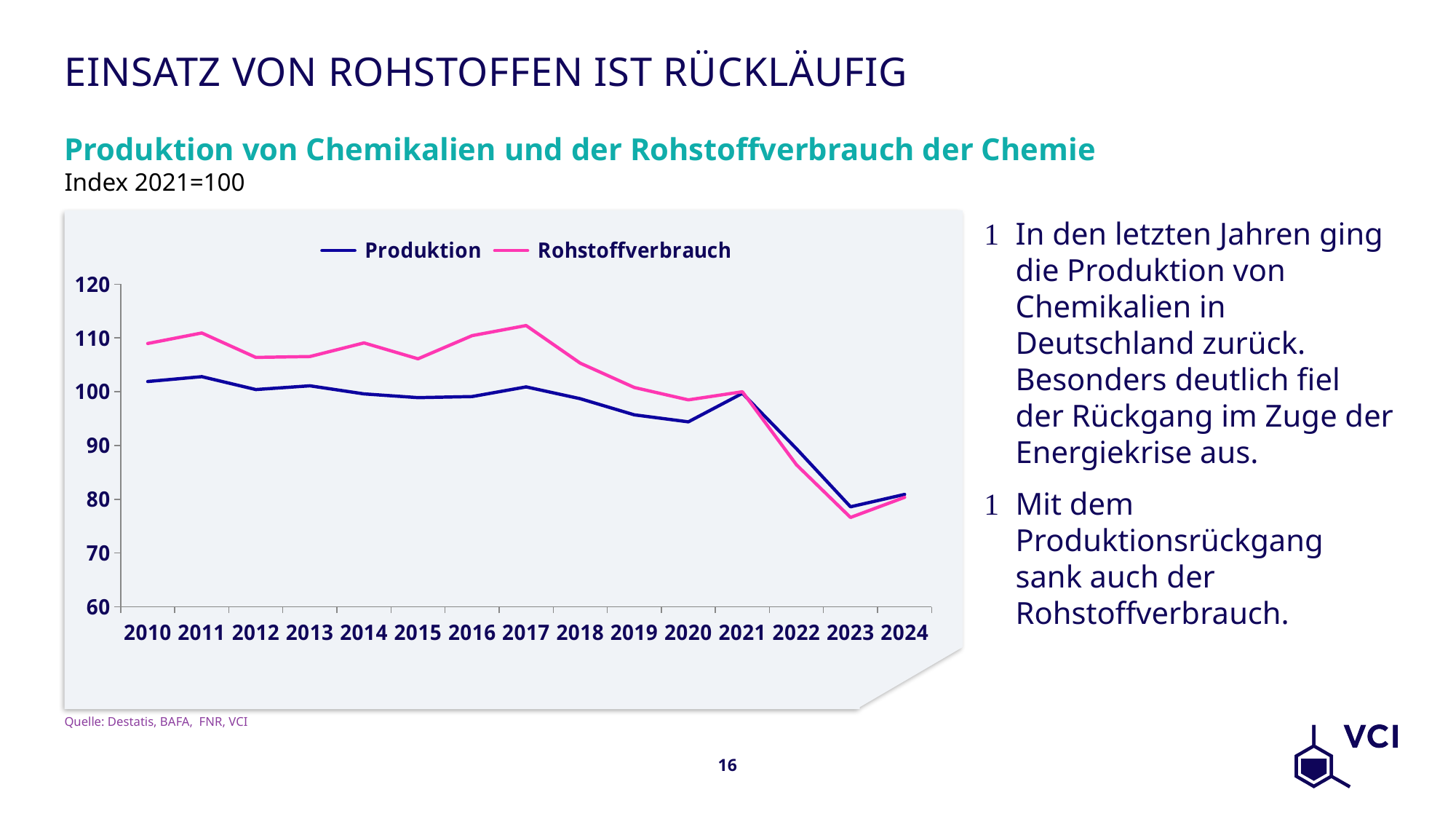
How many series does the legend list? 2 Is the value for Rohstoffverbrauch in 2023 greater or less than 80? less In which year is Rohstoffverbrauch at its lowest? 2023 What kind of chart is shown on the slide? line chart In 2017, which series has the higher value, Produktion or Rohstoffverbrauch? Rohstoffverbrauch In which year is Produktion at its lowest? 2023 How many years are shown on the x axis? 15 Is the value for Produktion in 2020 greater or less than 100? less Is the value for Rohstoffverbrauch in 2017 greater or less than 110? greater Does Rohstoffverbrauch rise or fall from 2017 to 2023? fall